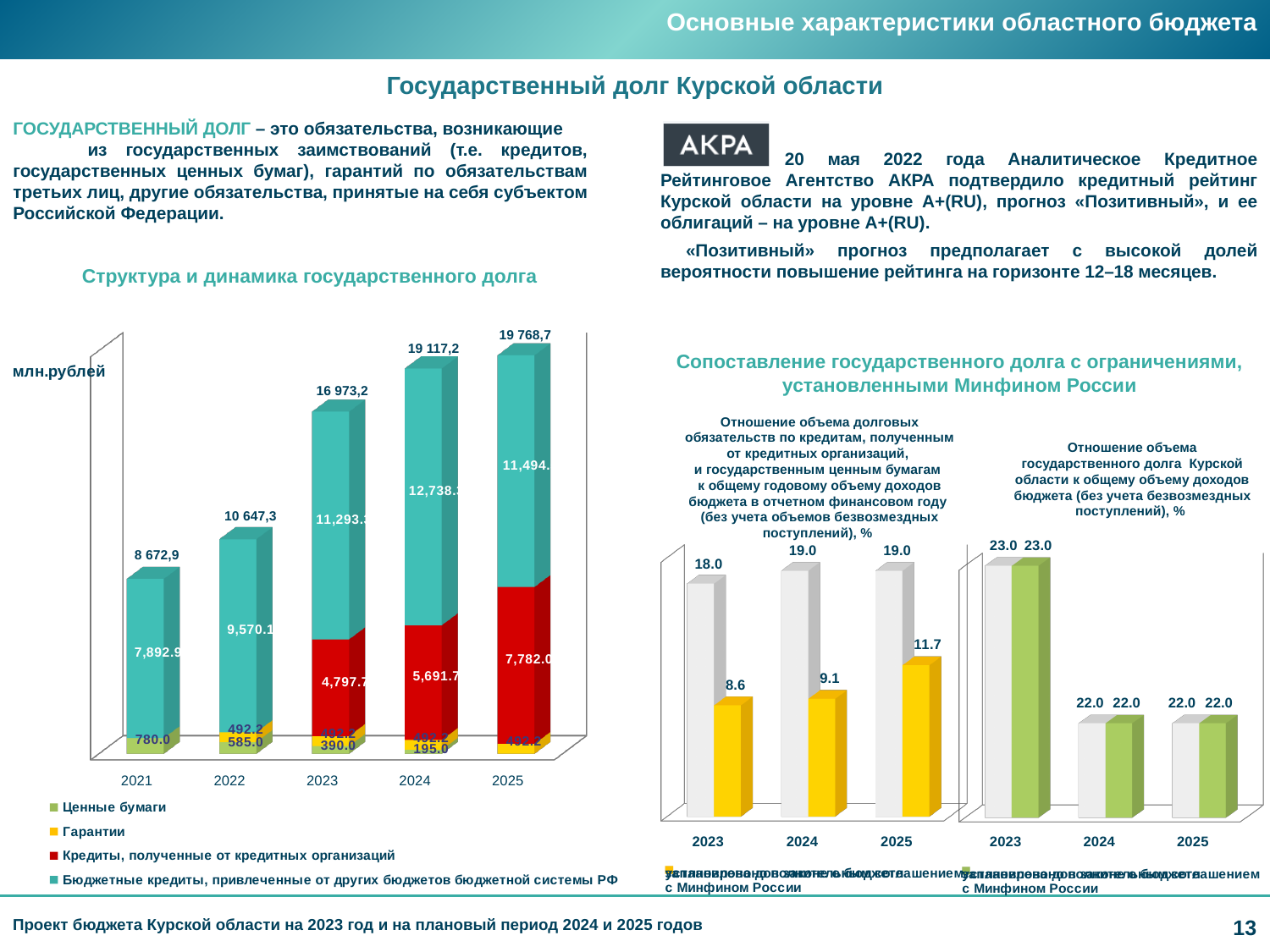
In the chart 'Структура и динамика государственного долга', which year has the highest total state debt? 2025 In the middle chart 'Отношение объема долговых обязательств по кредитам...', what is the difference between the two values shown for 2025 (19.0 and 11.7)? 7.3 In the chart 'Структура и динамика государственного долга', what is the value of 'Бюджетные кредиты, привлеченные от других бюджетов бюджетной системы РФ' for 2022? 9,570.1 In the chart 'Структура и динамика государственного долга', what is the total state debt shown for 2025? 19 768,7 In the chart 'Структура и динамика государственного долга', which year has the lowest total state debt? 2021 In the chart 'Структура и динамика государственного долга', how many series does the legend list? 4 In the chart 'Структура и динамика государственного долга', how many years are shown on the x axis? 5 In the middle chart 'Отношение объема долговых обязательств по кредитам...', what is the lower (yellow) value shown for 2025? 11.7 In the chart 'Структура и динамика государственного долга', what is the value of 'Кредиты, полученные от кредитных организаций' for 2025? 7,782.0 In the chart 'Структура и динамика государственного долга', do the total debt values rise or fall from 2021 to 2025? Rise In the chart 'Структура и динамика государственного долга', what is the total state debt shown for 2021? 8 672,9 What kind of chart is 'Структура и динамика государственного долга'? Stacked bar chart